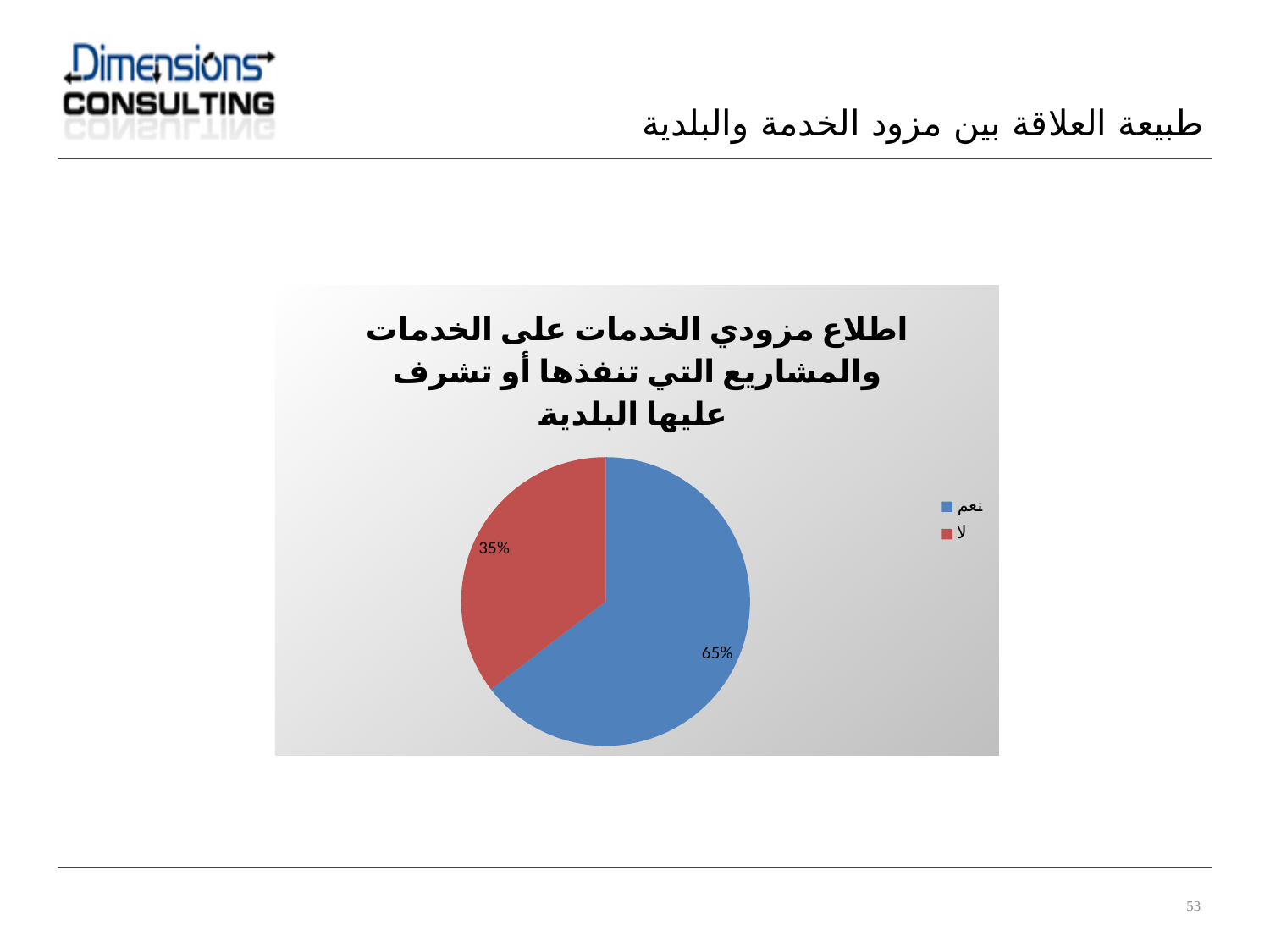
What colour is the "نعم" slice? blue What kind of chart is shown on the slide? pie chart What share of the pie does the "لا" slice represent? 35% Which slice is larger, "نعم" or "لا"? نعم Which category has the smallest slice of the pie? لا Which category has the largest slice of the pie? نعم What share of the pie does the "نعم" slice represent? 65% What colour is the "لا" slice? red How many entries does the legend list? 2 What is the difference in percentage points between the "نعم" and "لا" slices? 30% How many slices does the pie chart have? 2